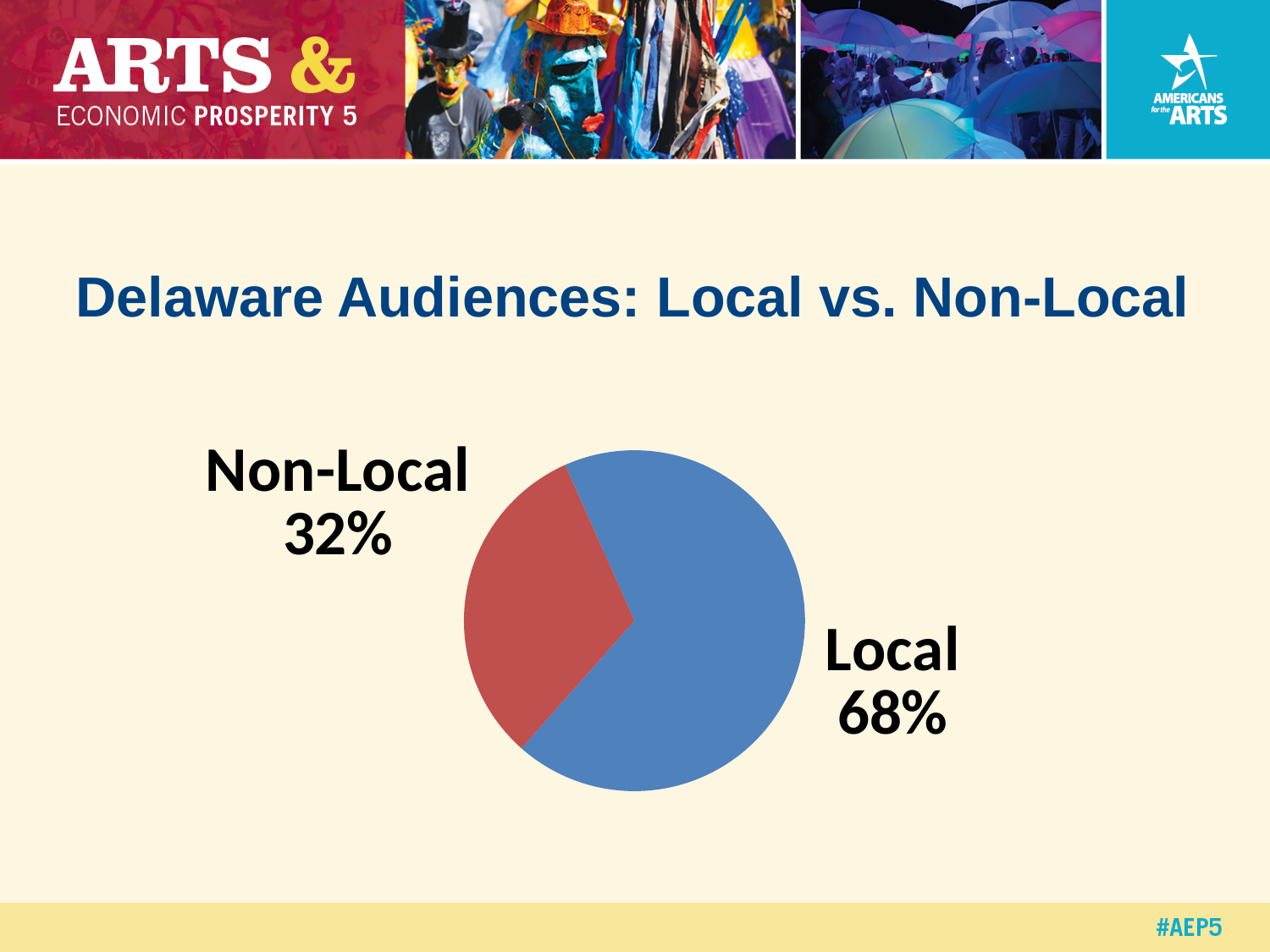
What kind of chart is shown on the slide? Pie chart Is the Local share greater or less than 50%? greater Which slice of the pie is the largest? Local What share of Delaware audiences is Non-Local? 32% What share of Delaware audiences is Local? 68% What colour is the Non-Local slice of the pie? Red What is the title of the slide's chart? Delaware Audiences: Local vs. Non-Local Which slice of the pie is the smallest? Non-Local How many slices does the pie chart have? 2 Which is larger, the Local share or the Non-Local share? Local What do the Local and Non-Local shares add up to? 100% What is the difference in percentage points between the Local and Non-Local shares? 36